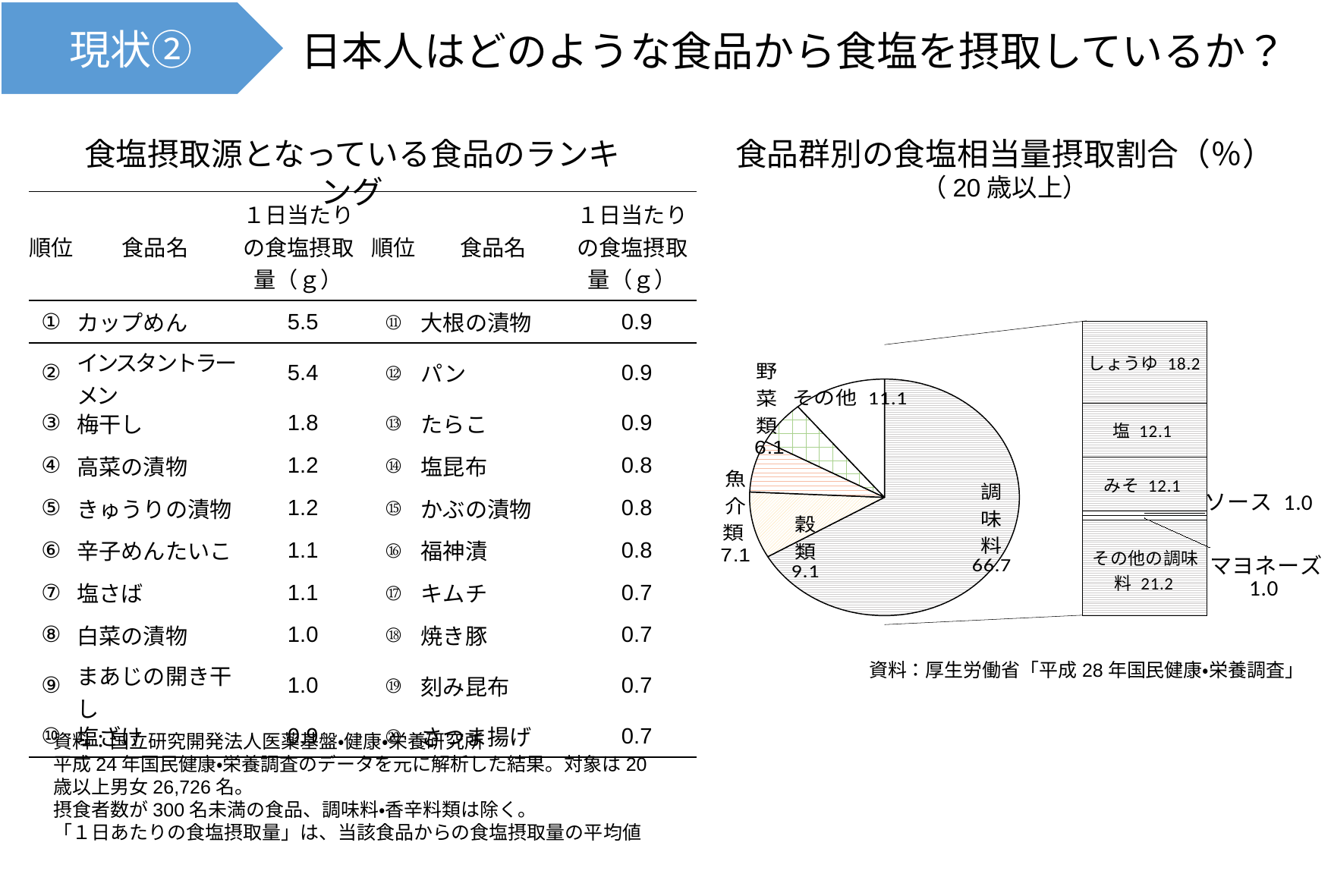
In the pie chart, which food group has the smallest share? 野菜類 In the breakdown of 調味料 next to the pie chart, what is the value for しょうゆ? 18.2 In the pie chart, what is the value for 魚介類? 7.1 In the pie chart, which food group has the largest share? 調味料 How many slices does the pie chart have? 5 In the pie chart, what is the difference between その他 and 穀類? 2.0 What kind of chart is used to show 食品群別の食塩相当量摂取割合? pie chart In the breakdown of 調味料 next to the pie chart, what is the value for その他の調味料? 21.2 In the pie chart, what is the value for 穀類? 9.1 In the pie chart, which is larger, 魚介類 or 野菜類? 魚介類 In the pie chart, what is the value for 調味料? 66.7 In the pie chart, what is the value for 野菜類? 6.1